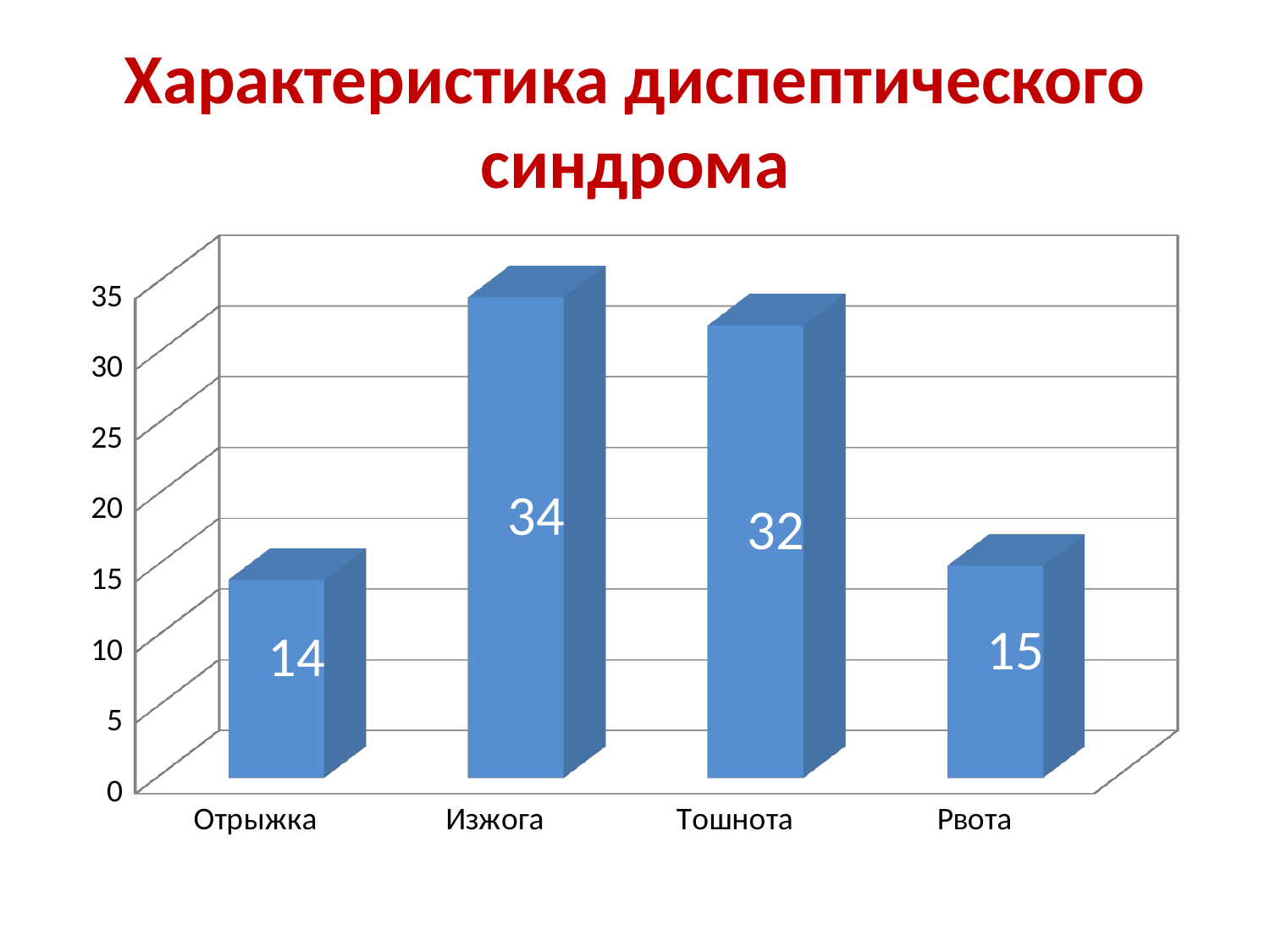
What is the title of the slide? Характеристика диспептического синдрома What kind of chart is shown on the slide? Bar chart What is the value for Рвота? 15 What is the value for Тошнота? 32 What is the value for Отрыжка? 14 What is the difference between the values for Изжога and Тошнота? 2 Which category has the lowest value? Отрыжка What is the value for Изжога? 34 What is the difference between the values for Рвота and Отрыжка? 1 Which is larger, the value for Тошнота or the value for Рвота? Тошнота How many categories are shown on the x axis? 4 Which category has the highest value? Изжога